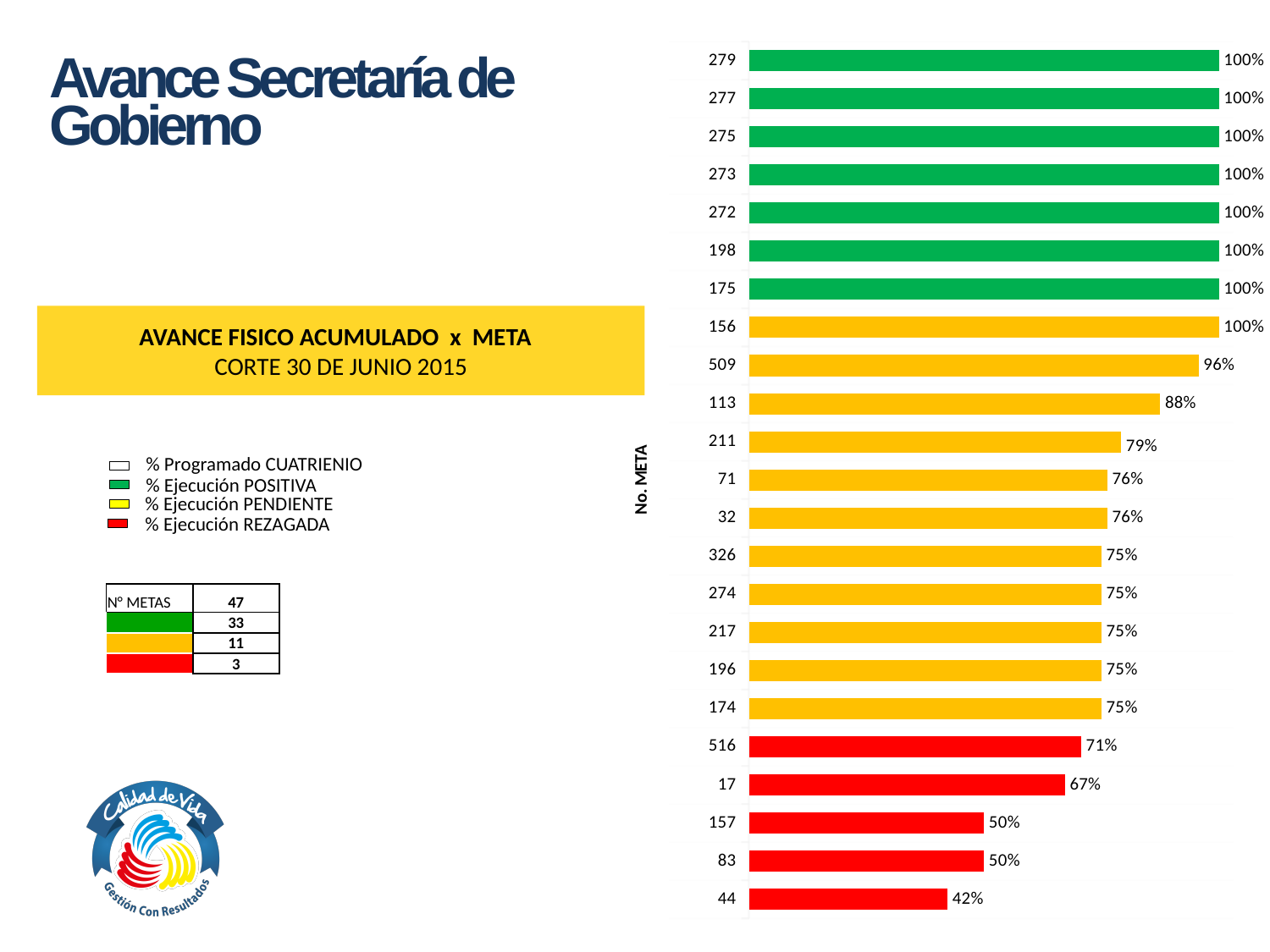
What is the value shown for meta 17? 67% What is the difference between the values for meta 516 and meta 44? 29% What is the value shown for meta 211? 79% What is the value shown for meta 44? 42% Which meta has the lowest value in the chart? 44 Which has a larger value, meta 211 or meta 516? 211 What is the value shown for meta 509? 96% What is the value shown for meta 113? 88% How many metas (bars) are shown in the chart? 23 What is the title of the vertical axis of the chart? No. META What is the difference between the values for meta 509 and meta 113? 8% What kind of chart is shown on the slide? bar chart